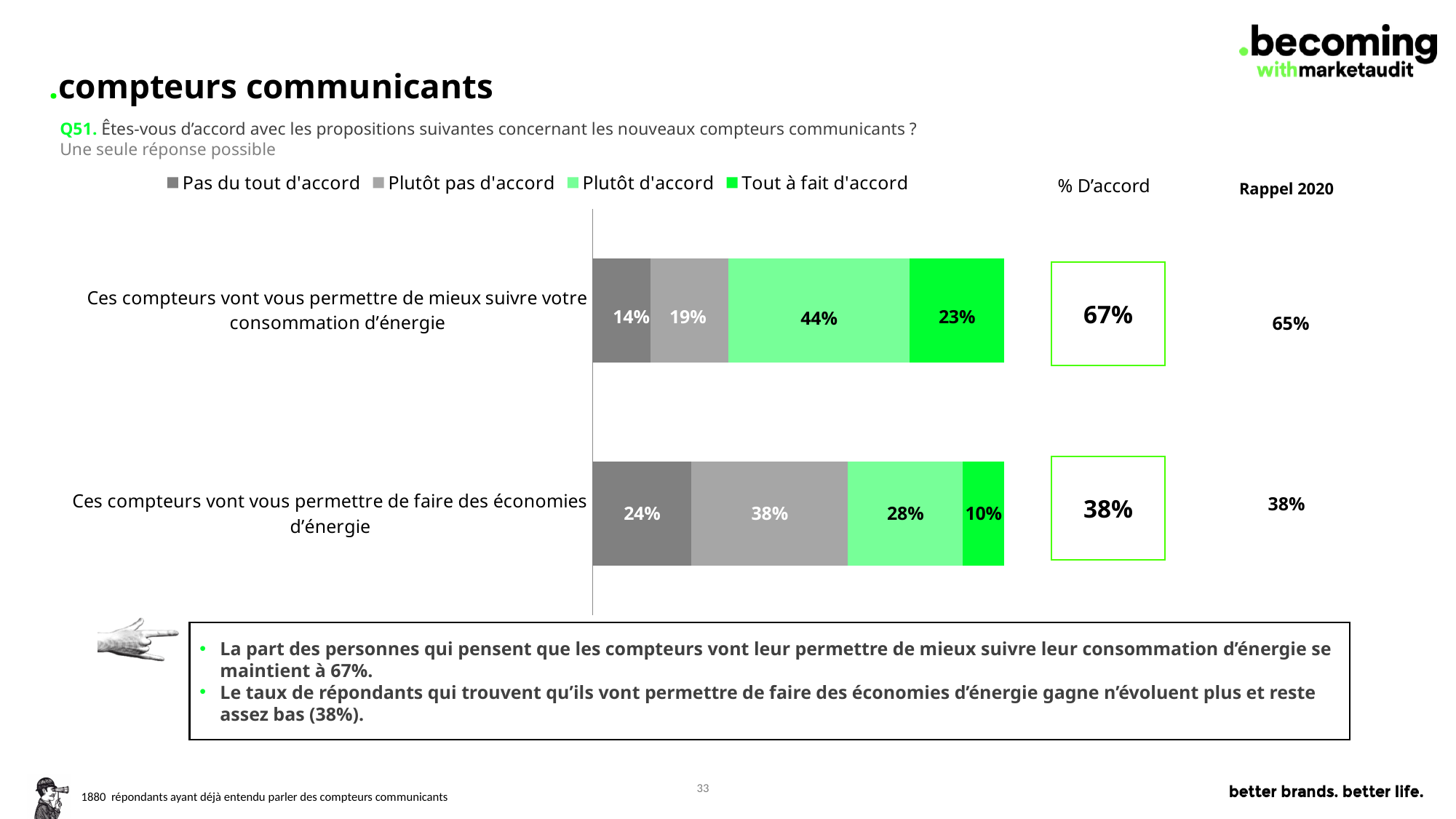
What is the "Tout à fait d'accord" value for "Ces compteurs vont vous permettre de faire des économies d'énergie"? 10% What is the "Rappel 2020" value for "Ces compteurs vont vous permettre de mieux suivre votre consommation d'énergie"? 65% What percentage of respondents answered "Plutôt d'accord" to "Ces compteurs vont vous permettre de mieux suivre votre consommation d'énergie"? 44% What type of chart is shown on the slide? Stacked bar chart Which response category has the smallest share for "Ces compteurs vont vous permettre de mieux suivre votre consommation d'énergie"? Pas du tout d'accord How many series does the legend list? 4 Which response category has the largest share for "Ces compteurs vont vous permettre de faire des économies d'énergie"? Plutôt pas d'accord What is the "% D'accord" shown for "Ces compteurs vont vous permettre de faire des économies d'énergie"? 38% What is the "Plutôt pas d'accord" value for "Ces compteurs vont vous permettre de mieux suivre votre consommation d'énergie"? 19% What is the difference between the "Plutôt d'accord" values of the two propositions? 16 percentage points What percentage of respondents answered "Pas du tout d'accord" to "Ces compteurs vont vous permettre de faire des économies d'énergie"? 24% Which proposition has the higher "Tout à fait d'accord" share? Ces compteurs vont vous permettre de mieux suivre votre consommation d'énergie